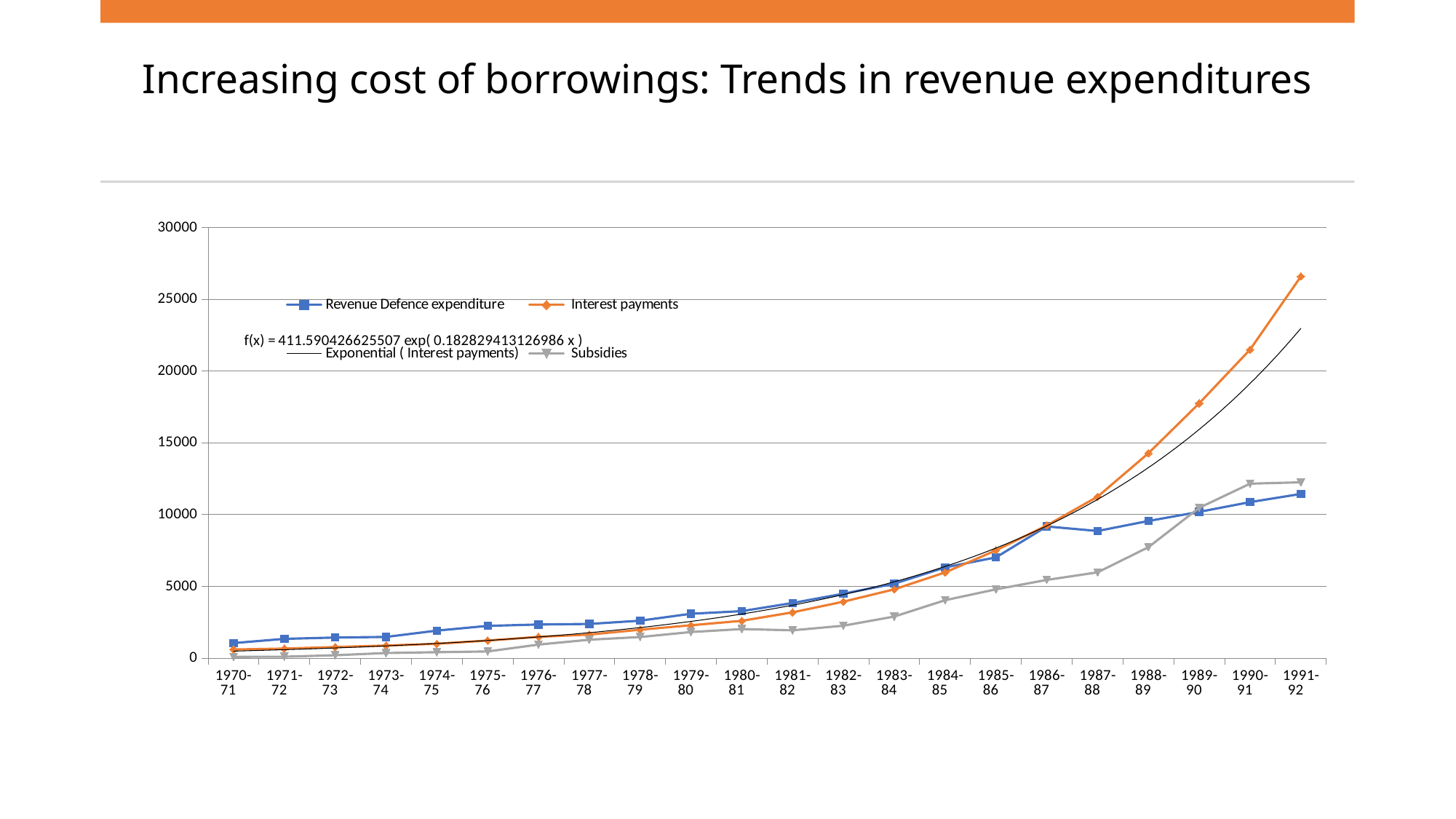
Is the value for Subsidies in 1990-91 greater or less than 10000? greater How many entries does the chart's legend list? 4 In 1980-81, which is larger: Revenue Defence expenditure or Subsidies? Revenue Defence expenditure What kind of chart is shown on the slide? line chart Is the value for Interest payments in 1989-90 greater or less than 15000? greater What is the title of the slide containing the chart? Increasing cost of borrowings: Trends in revenue expenditures Do Interest payments rise or fall from 1970-71 to 1991-92? rise Which series has the highest value in 1991-92? Interest payments Which series has the lowest value in 1970-71? Subsidies Is the value for Interest payments in 1991-92 greater or less than 25000? greater How many years are plotted along the x axis? 22